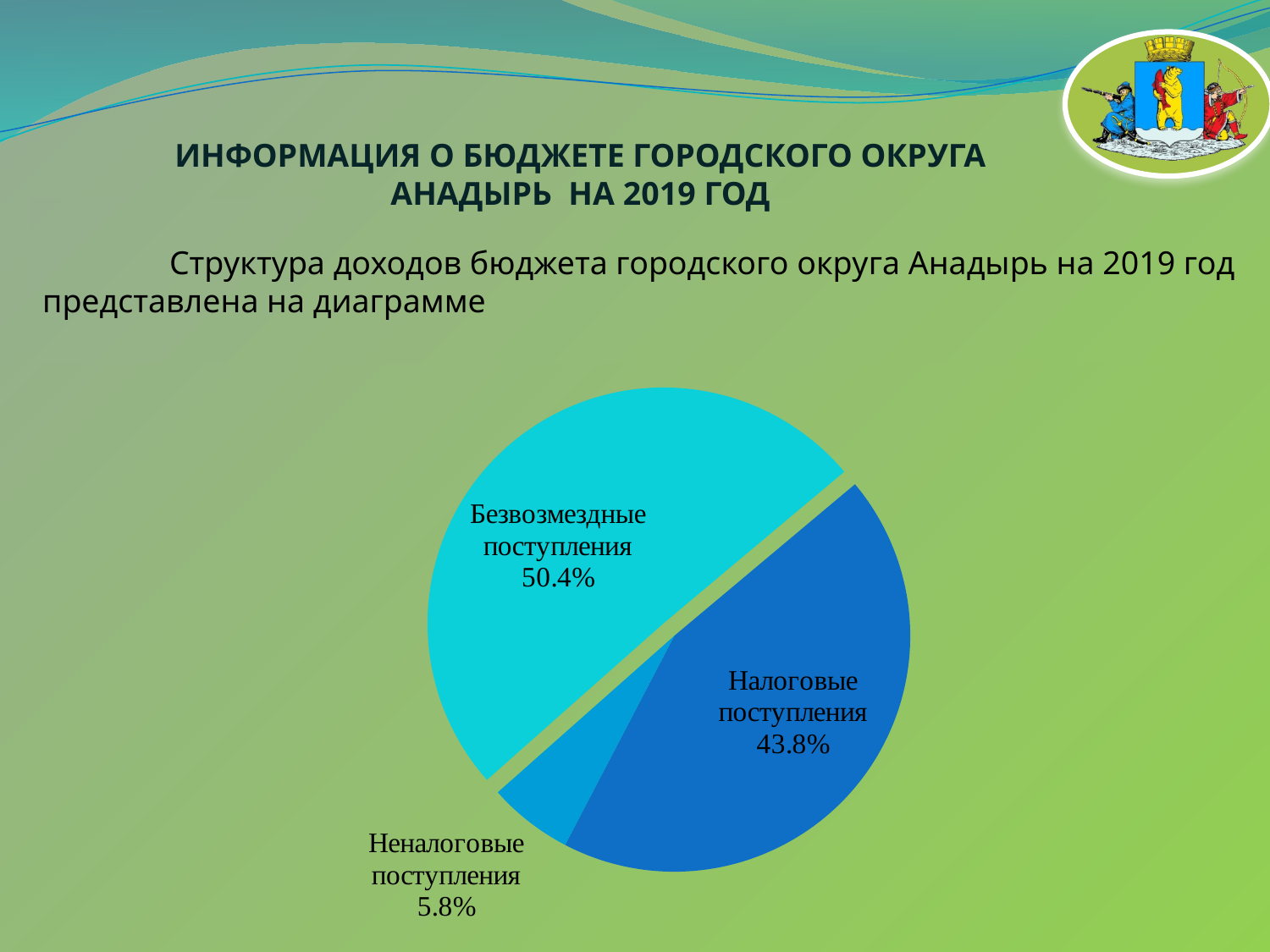
What share of the pie does Неналоговые поступления represent? 5.8% What share of the pie does Налоговые поступления represent? 43.8% What kind of chart is shown on the slide? Pie chart Which is larger, Безвозмездные поступления or Налоговые поступления? Безвозмездные поступления Which category has the largest slice of the pie? Безвозмездные поступления Which is larger, Налоговые поступления or Неналоговые поступления? Налоговые поступления What is the difference in percentage points between Налоговые поступления and Неналоговые поступления? 38 Which category has the smallest slice of the pie? Неналоговые поступления What is the difference in percentage points between Безвозмездные поступления and Налоговые поступления? 6.6 How many categories are shown in the pie chart? 3 What share of the pie does Безвозмездные поступления represent? 50.4% Which slice of the pie is separated (exploded) from the rest? Безвозмездные поступления